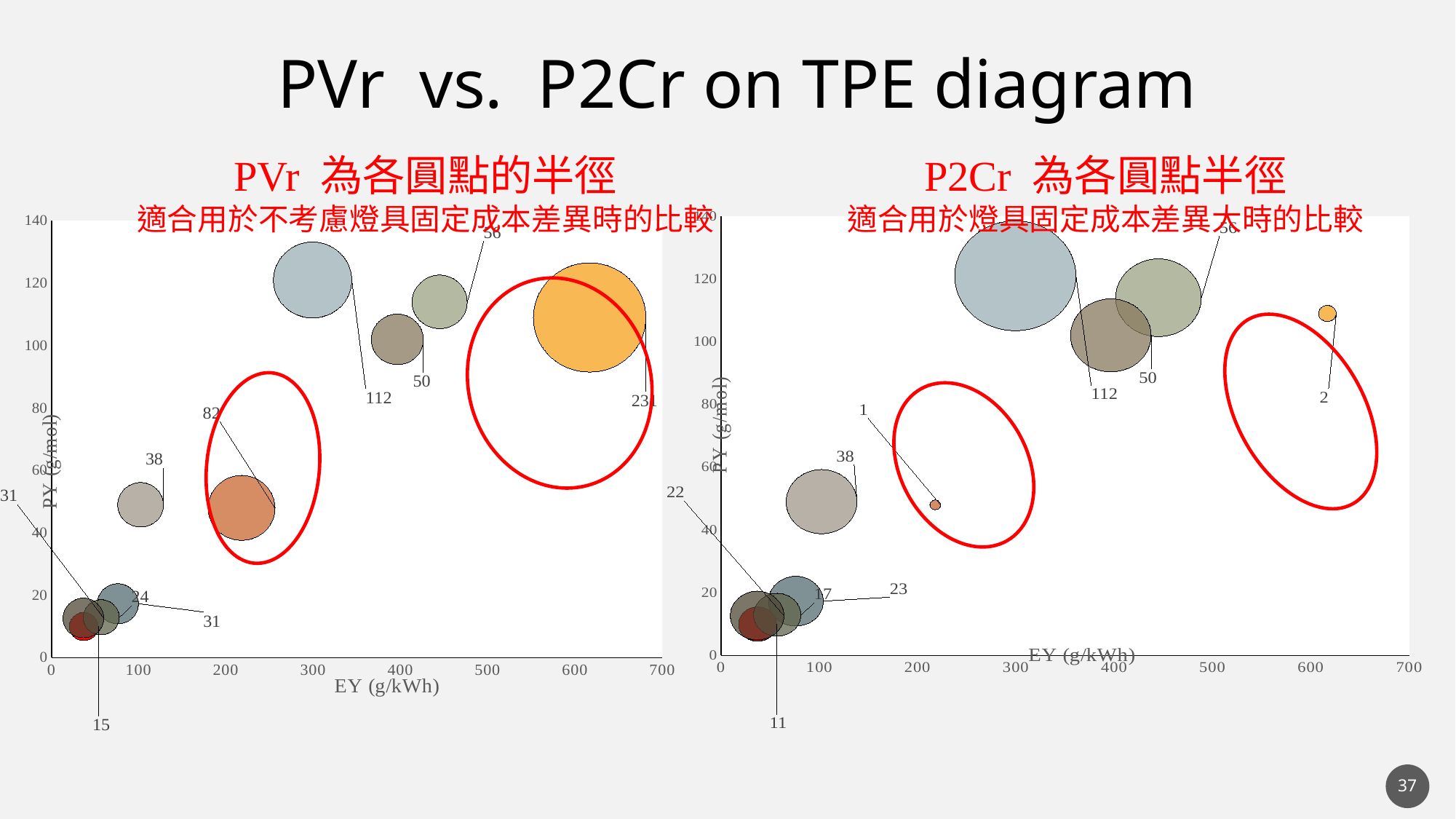
In the left chart (PVr 為各圓點的半徑), what is the y-axis title? PY (g/mol) How many charts are shown on the slide? 2 In the left chart (PVr 為各圓點的半徑), which bubble has the largest labelled value? 231 In the right chart (P2Cr 為各圓點半徑), what is the label of the small orange bubble near EY 600? 2 In the right chart (P2Cr 為各圓點半徑), which bubble has the smallest labelled value? 1 In the left chart (PVr 為各圓點的半徑), which bubble has the smallest labelled value? 15 In the left chart (PVr 為各圓點的半徑), what is the difference between the bubble labelled 231 and the bubble labelled 112? 119 In the left chart (PVr 為各圓點的半徑), is the PY value of the bubble labelled 231 greater or less than 100? greater In the left chart (PVr 為各圓點的半徑), what is the x-axis title? EY (g/kWh) What kind of chart is the left chart (PVr 為各圓點的半徑)? bubble chart In the right chart (P2Cr 為各圓點半徑), is the EY value of the bubble labelled 38 greater or less than 200? less In the left chart (PVr 為各圓點的半徑), what is the label of the large orange bubble? 231